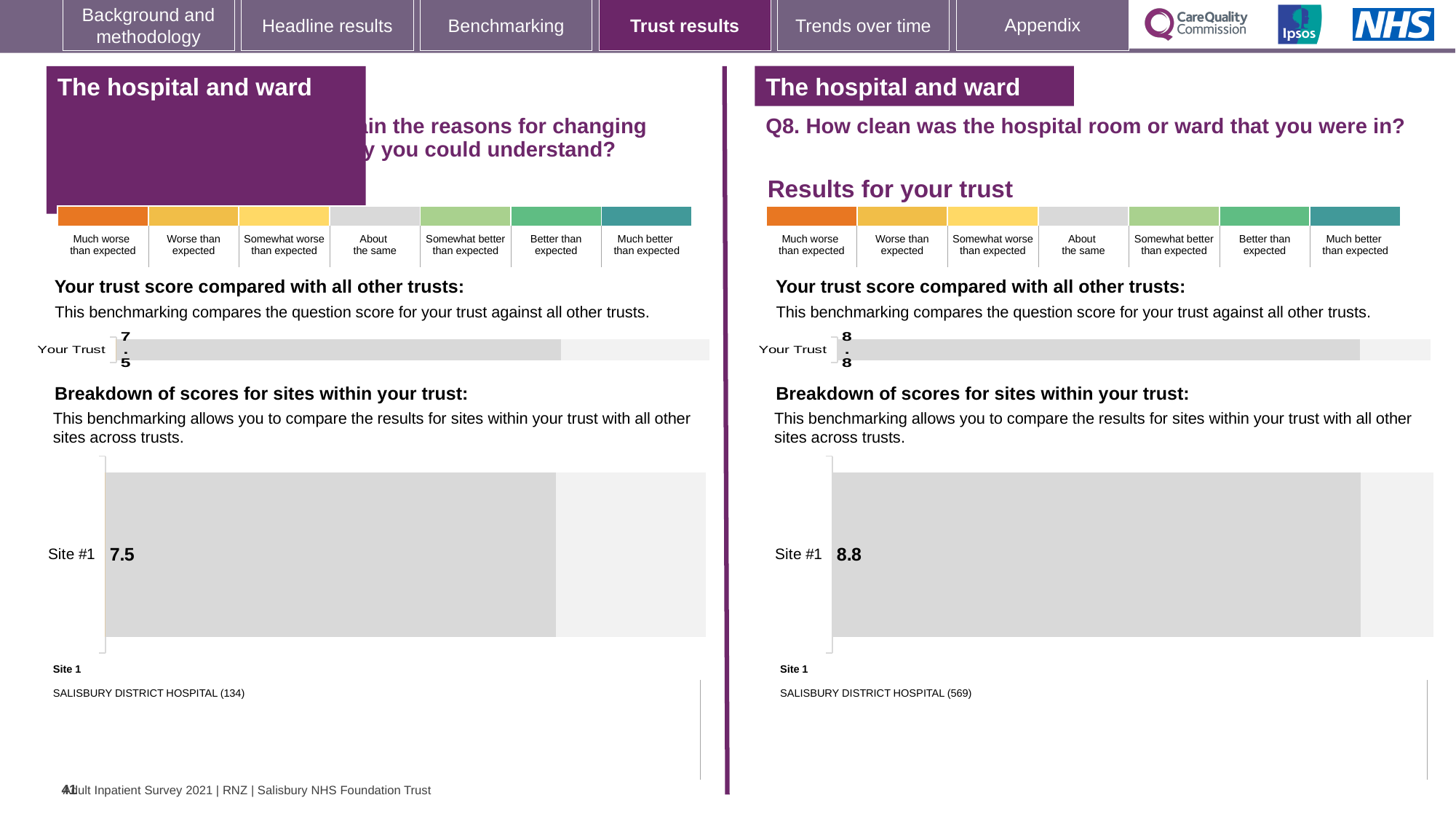
On the right-hand chart (Q8. How clean was the hospital room or ward that you were in?), what is the score shown for Your Trust? 8.8 How many sites are shown in the breakdown of scores for sites within your trust on the left-hand chart? 1 How many rating categories are shown in the colour scale above the right-hand chart (Q8), from 'Much worse than expected' to 'Much better than expected'? 7 What is the difference between the Site #1 score on the right-hand chart (Q8) and the Site #1 score on the left-hand chart? 1.3 On the right-hand chart (Q8), which hospital is listed as Site 1? SALISBURY DISTRICT HOSPITAL How many sites are shown in the breakdown of scores for sites within your trust on the right-hand chart (Q8)? 1 What kind of chart is used to show the breakdown of scores for sites within your trust on the right-hand side (Q8)? Bar chart On the left-hand chart, what is the score shown for Site #1 in the breakdown of scores for sites within your trust? 7.5 Which is larger: the Site #1 score on the left-hand chart or the Site #1 score on the right-hand chart (Q8)? The right-hand chart (Q8) On the right-hand chart (Q8), what is the score shown for Site #1 in the breakdown of scores for sites within your trust? 8.8 On the left-hand chart, what is the score shown for Your Trust? 7.5